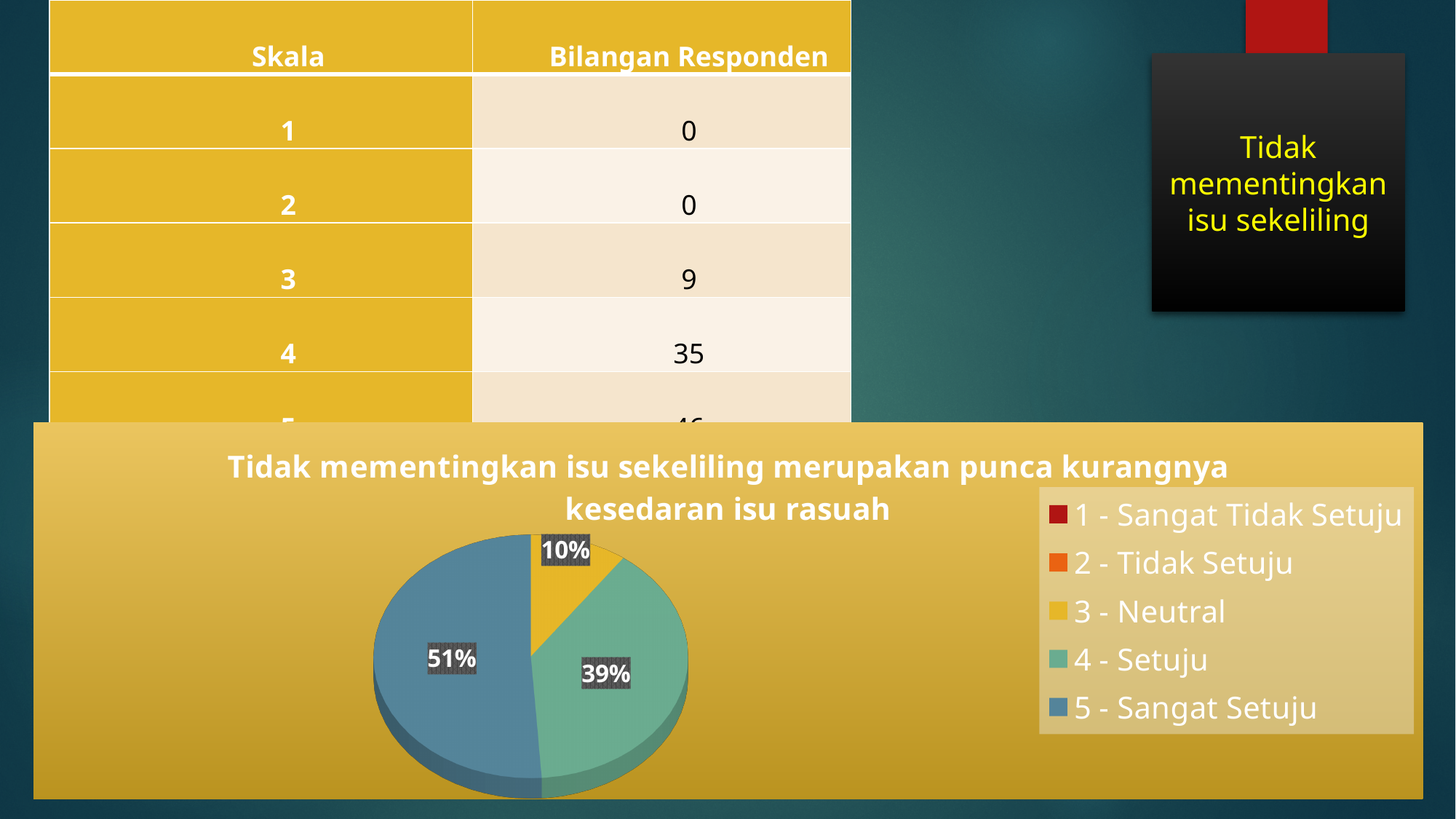
Which slice is larger, 4 - Setuju or 3 - Neutral? 4 - Setuju What percentage of the pie is labelled for the 4 - Setuju slice? 39% Of the slices with a printed label, which category has the smallest share? 3 - Neutral How many entries does the legend of the pie chart list? 5 What type of chart is shown on the slide? pie chart What is the title of the pie chart? Tidak mementingkan isu sekeliling merupakan punca kurangnya kesedaran isu rasuah Which category has the largest slice of the pie? 5 - Sangat Setuju What is the difference in percentage points between the 5 - Sangat Setuju slice and the 4 - Setuju slice? 12 Is the share for 5 - Sangat Setuju greater or less than 50%? greater What percentage of the pie is labelled for the 3 - Neutral slice? 10% How many slices with a printed percentage label are visible in the pie chart? 3 What percentage of the pie is labelled for the 5 - Sangat Setuju slice? 51%